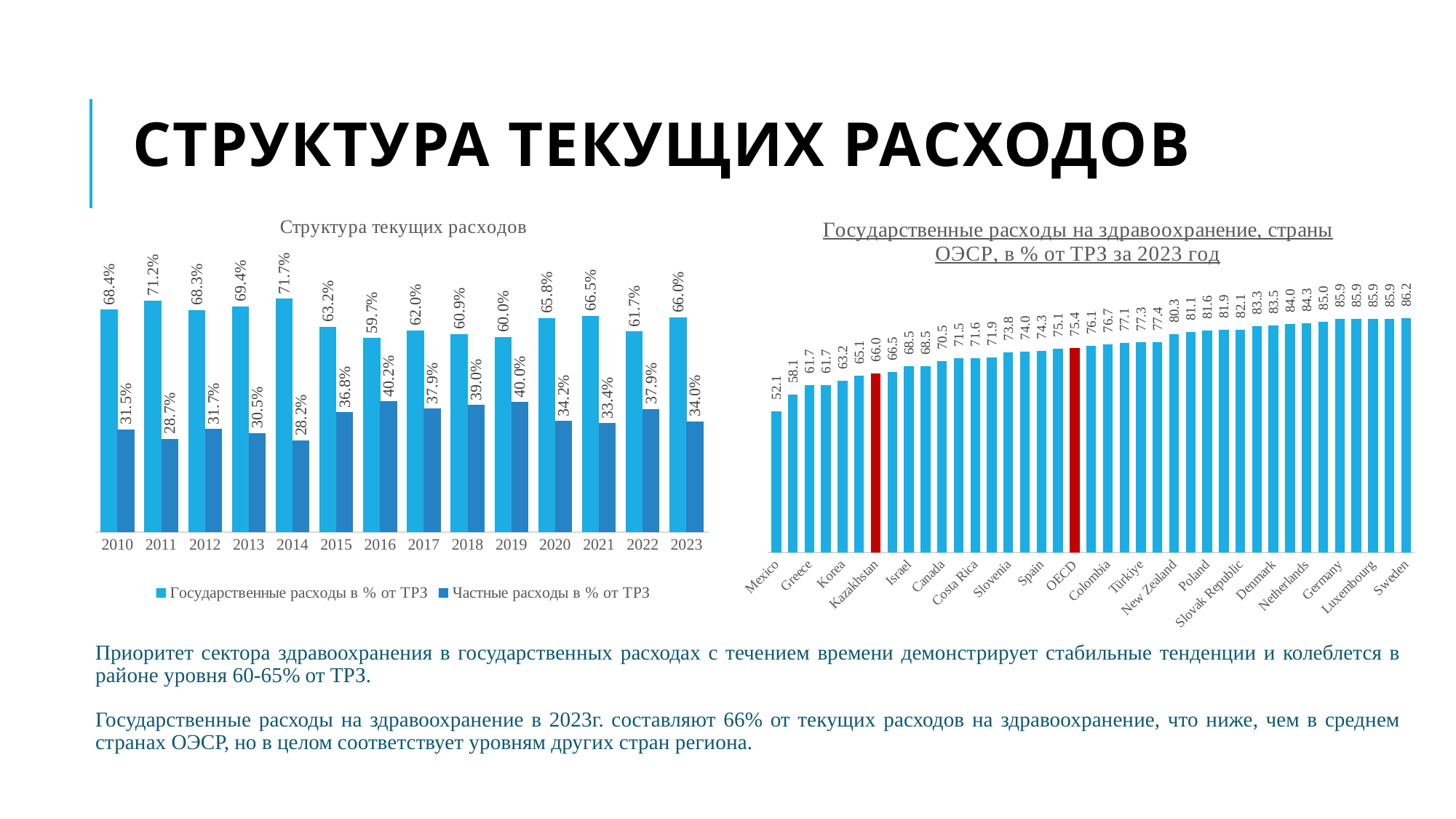
In the left chart 'Структура текущих расходов', what is the difference between the public and private expenditure values for 2023? 32.0 percentage points In the left chart 'Структура текущих расходов', what is the value of 'Частные расходы в % от ТРЗ' for 2016? 40.2% In the right chart 'Государственные расходы на здравоохранение, страны ОЭСР', what is the value for Kazakhstan? 66.0 In the left chart 'Структура текущих расходов', how many series does the legend list? 2 In the right chart 'Государственные расходы на здравоохранение, страны ОЭСР', what is the value for Mexico? 52.1 In the left chart 'Структура текущих расходов', which year has the lowest value for 'Государственные расходы в % от ТРЗ'? 2016 In the left chart 'Структура текущих расходов', what is the value of 'Государственные расходы в % от ТРЗ' for 2014? 71.7% In the left chart 'Структура текущих расходов', how many years are shown on the x axis? 14 In the right chart 'Государственные расходы на здравоохранение, страны ОЭСР', which country has the highest value? Sweden What kind of chart is the right chart 'Государственные расходы на здравоохранение, страны ОЭСР'? Bar chart In the left chart 'Структура текущих расходов', which year has the highest value for 'Государственные расходы в % от ТРЗ'? 2014 In the left chart 'Структура текущих расходов', is the private expenditure value for 2011 larger or smaller than for 2018? smaller